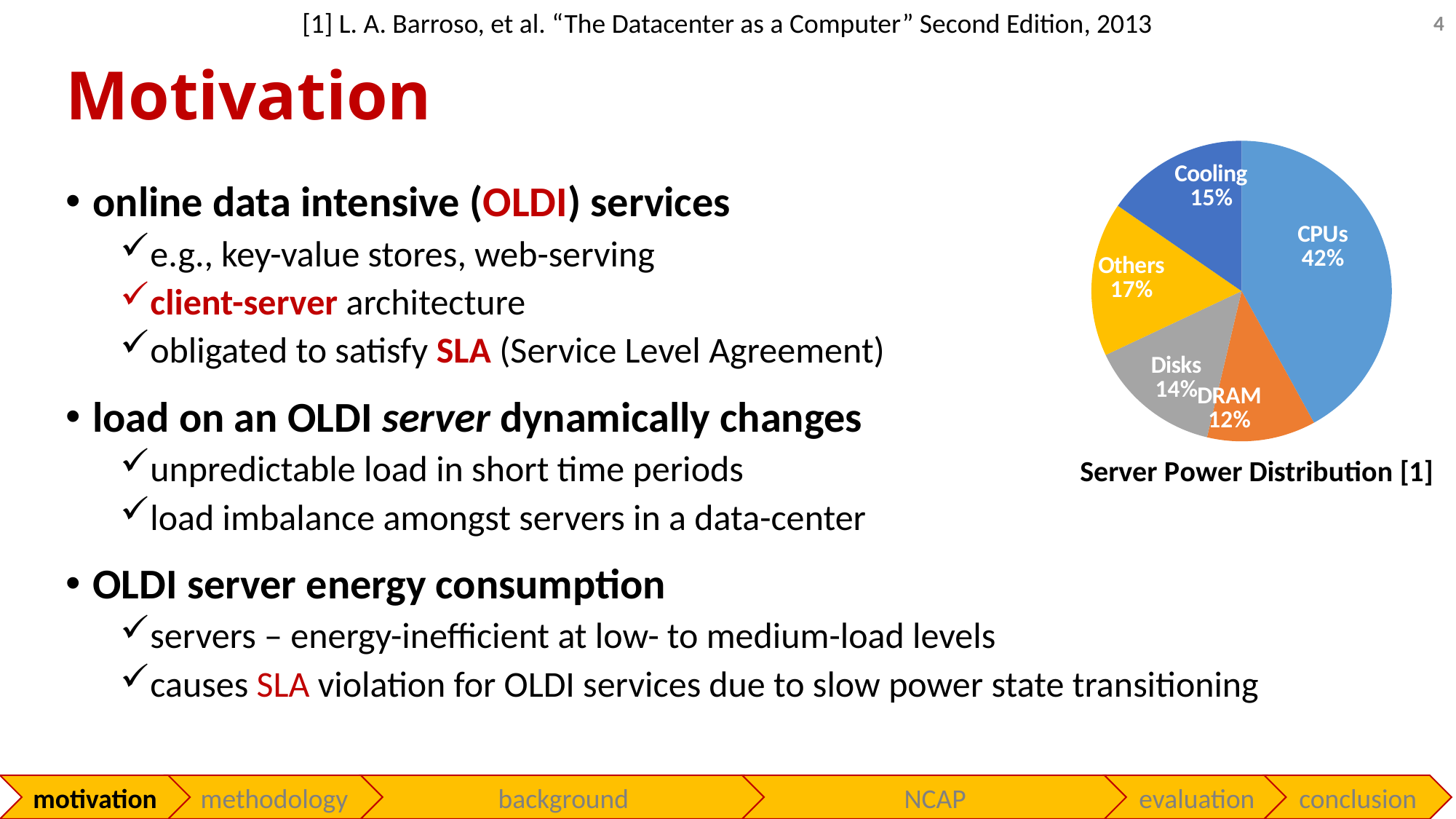
What is the difference between the CPUs share and the Others share in the Server Power Distribution chart? 25% What is the combined share of Disks and DRAM in the Server Power Distribution chart? 26% What share of server power goes to CPUs in the Server Power Distribution pie chart? 42% How many categories are shown in the Server Power Distribution pie chart? 5 Which category has the smallest slice in the Server Power Distribution pie chart? DRAM What is the value for DRAM in the Server Power Distribution chart? 12% What percentage of the Server Power Distribution pie is Cooling? 15% Which category has the largest slice in the Server Power Distribution pie chart? CPUs What kind of chart is the Server Power Distribution chart? pie chart What colour is the Others slice in the Server Power Distribution pie chart? yellow In the Server Power Distribution chart, which is larger: Disks or Cooling? Cooling What is the title of the chart on the slide? Server Power Distribution [1]